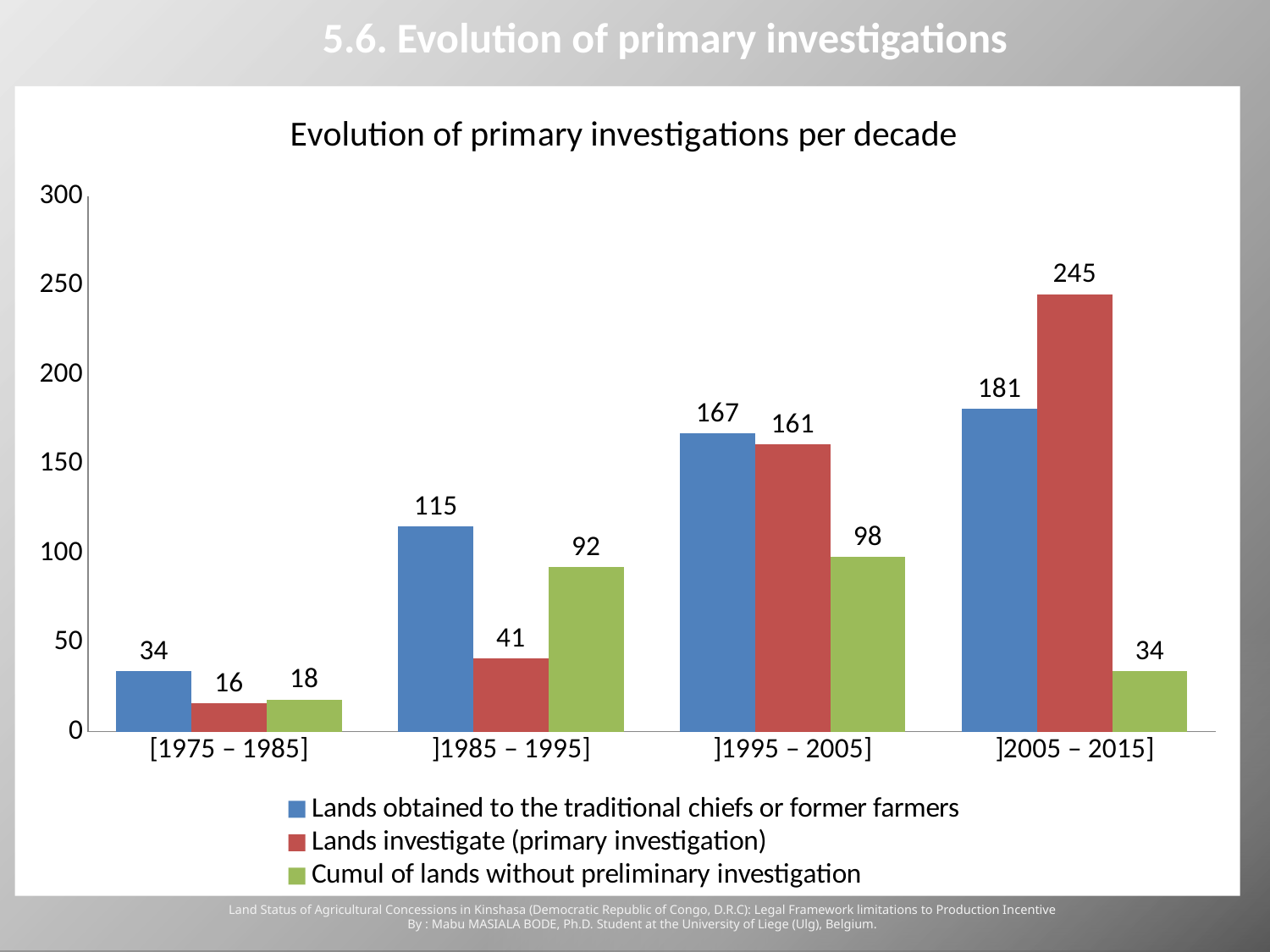
What is the value for 'Lands investigate (primary investigation)' in the [1975 – 1985] decade? 16 Is the value for 'Lands investigate (primary investigation)' in ]1985 – 1995] greater or less than 50? less What is the value for 'Cumul of lands without preliminary investigation' in the ]1985 – 1995] decade? 92 What is the value for 'Lands obtained to the traditional chiefs or former farmers' in the ]2005 – 2015] decade? 181 Does 'Lands investigate (primary investigation)' rise or fall across the decades from [1975 – 1985] to ]2005 – 2015]? rise How many series does the legend list? 3 What is the difference between 'Lands investigate (primary investigation)' and 'Lands obtained to the traditional chiefs or former farmers' in the ]2005 – 2015] decade? 64 In which decade is 'Lands obtained to the traditional chiefs or former farmers' lowest? [1975 – 1985] How many decades are shown on the x axis? 4 In which decade is 'Lands investigate (primary investigation)' highest? ]2005 – 2015] What kind of chart is shown? bar chart In the ]1995 – 2005] decade, which is larger: 'Lands obtained to the traditional chiefs or former farmers' or 'Lands investigate (primary investigation)'? Lands obtained to the traditional chiefs or former farmers